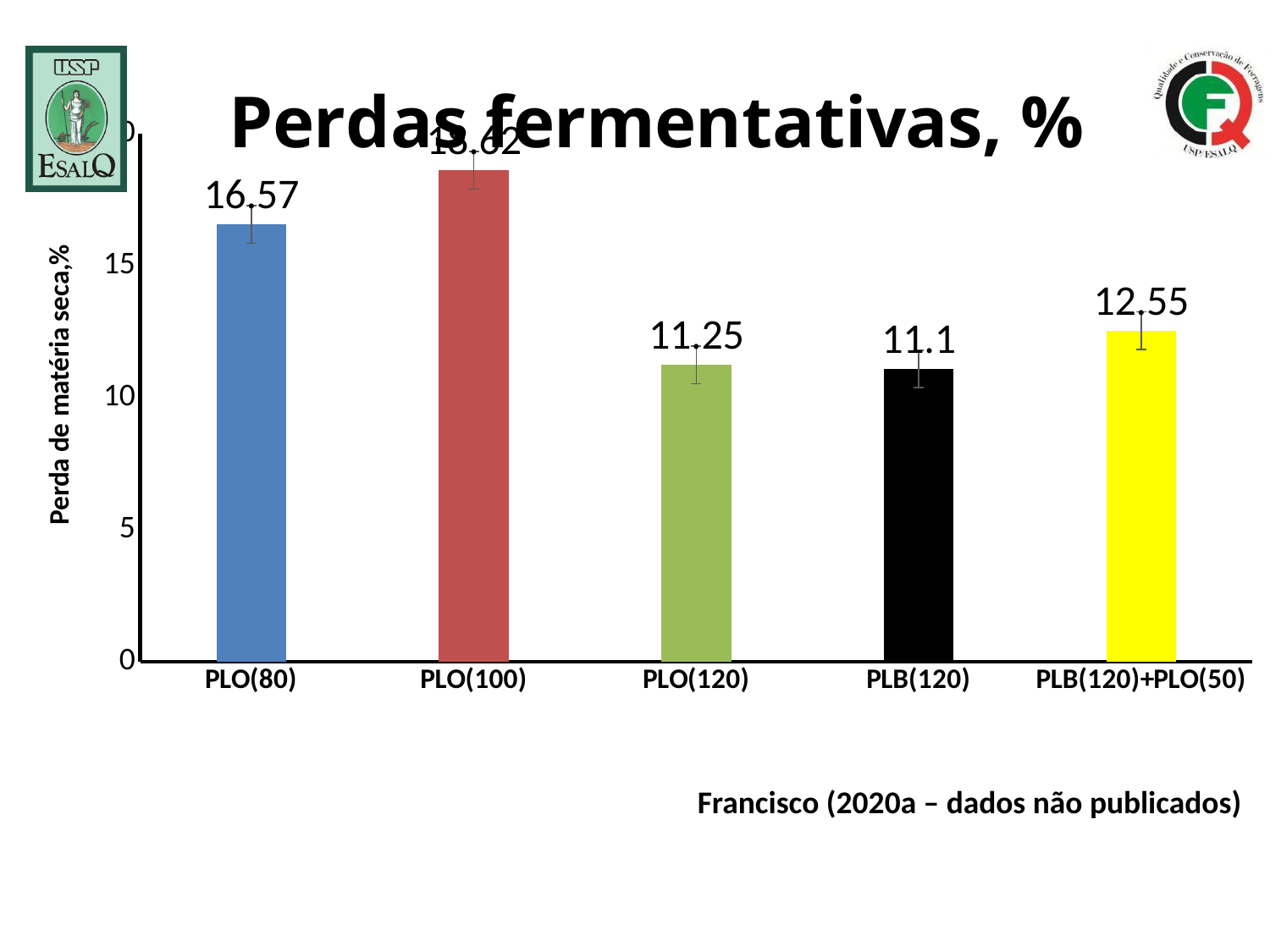
Which category has the highest value? PLO(100) Which is larger, the value for PLO(80) or the value for PLB(120)+PLO(50)? PLO(80) What is the difference between the values for PLO(80) and PLO(120)? 5.32 What is the difference between the values for PLB(120)+PLO(50) and PLB(120)? 1.45 What is the value for PLB(120)? 11.1 What is the value for PLO(120)? 11.25 Is the value for PLO(100) greater or less than 15? greater What is the value for PLO(80)? 16.57 How many categories are shown on the x axis? 5 What is the value for PLB(120)+PLO(50)? 12.55 What kind of chart is shown on the slide? bar chart Which category has the lowest value? PLB(120)